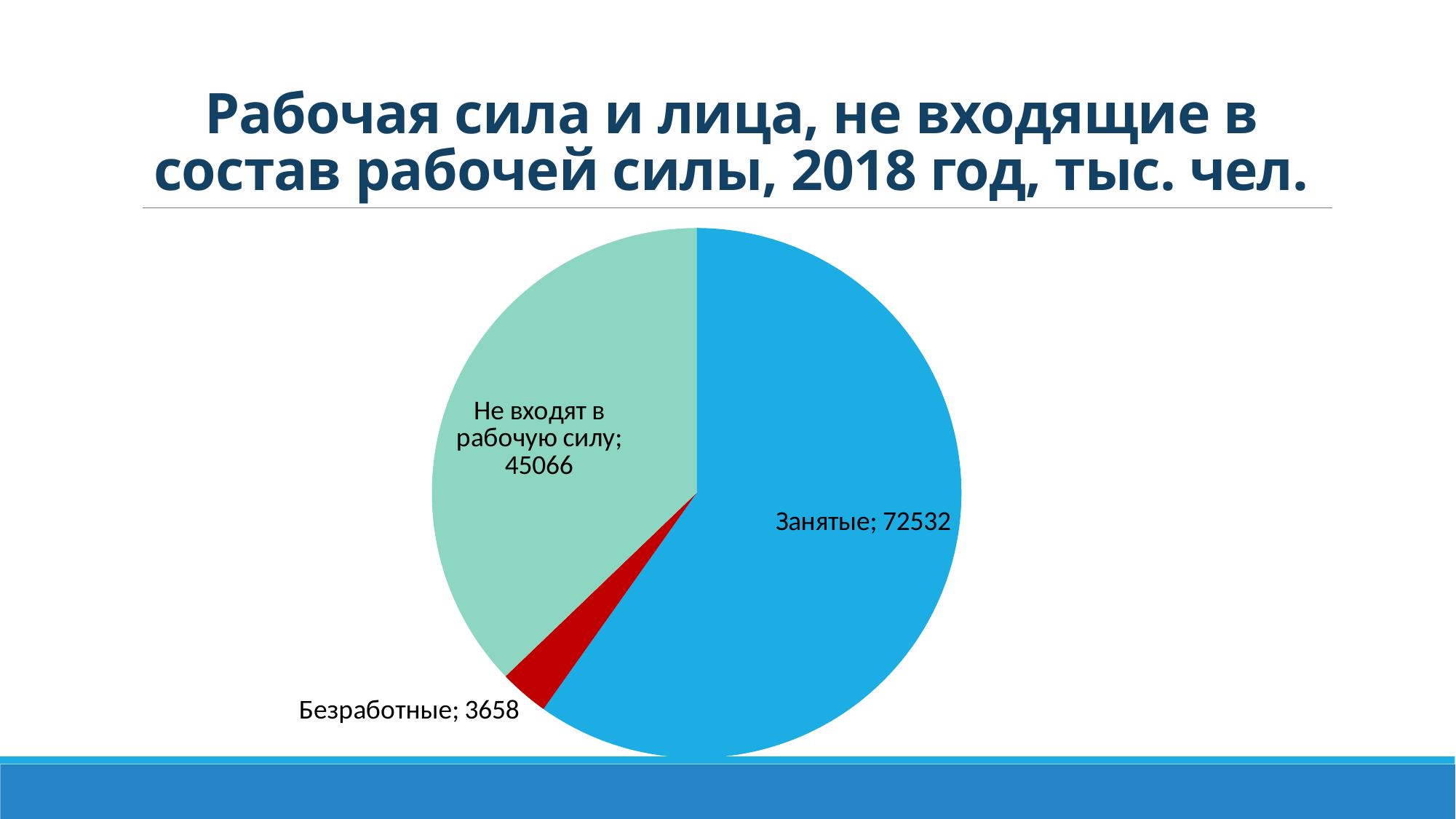
Which is larger, the value for Занятые or the value for Не входят в рабочую силу? Занятые How many slices does the pie chart have? 3 What share of the pie does the Занятые slice represent? 59.8% What is the total of all three slices of the pie? 121256 What is the value for Безработные? 3658 What is the value for Не входят в рабочую силу? 45066 What is the difference between the values for Занятые and Не входят в рабочую силу? 27466 Which category has the smallest slice of the pie? Безработные Which category has the largest slice of the pie? Занятые What is the value for Занятые? 72532 What is the difference between the values for Не входят в рабочую силу and Безработные? 41408 What type of chart is shown on the slide? pie chart